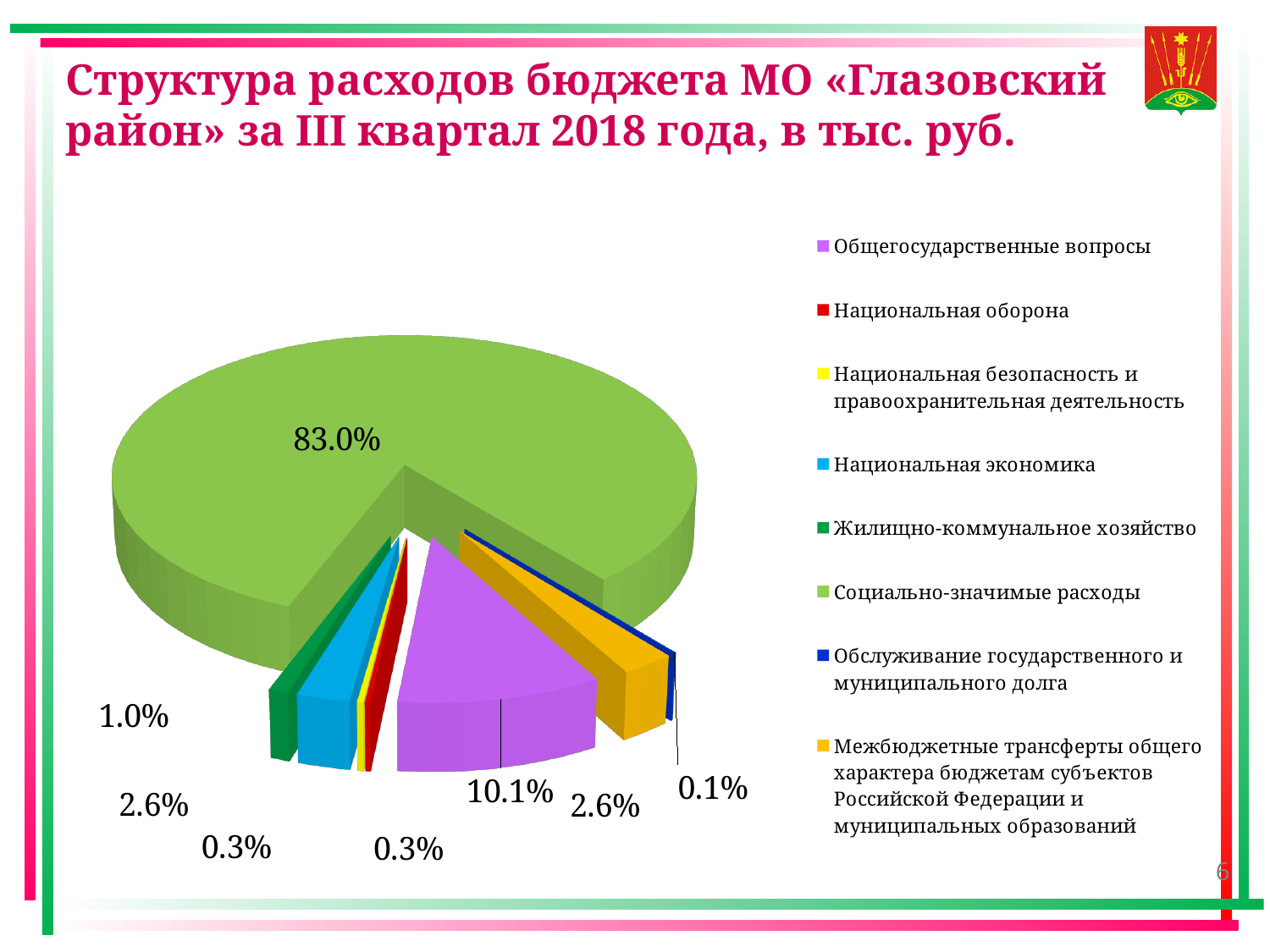
What percentage is shown for Национальная оборона? 0.3% What percentage is shown for Жилищно-коммунальное хозяйство? 1.0% What is the value for Обслуживание государственного и муниципального долга? 0.1% How many categories does the legend list? 8 What share is shown for Национальная экономика? 2.6% Which category has the smallest share of the pie? Обслуживание государственного и муниципального долга Which category has the largest share of the pie? Социально-значимые расходы What is the value shown for Общегосударственные вопросы? 10.1% What share of the pie does Социально-значимые расходы account for? 83.0% Which is larger: the share for Общегосударственные вопросы or for Жилищно-коммунальное хозяйство? Общегосударственные вопросы By how many percentage points does Социально-значимые расходы exceed Общегосударственные вопросы? 72.9 percentage points What type of chart is shown on the slide? Pie chart